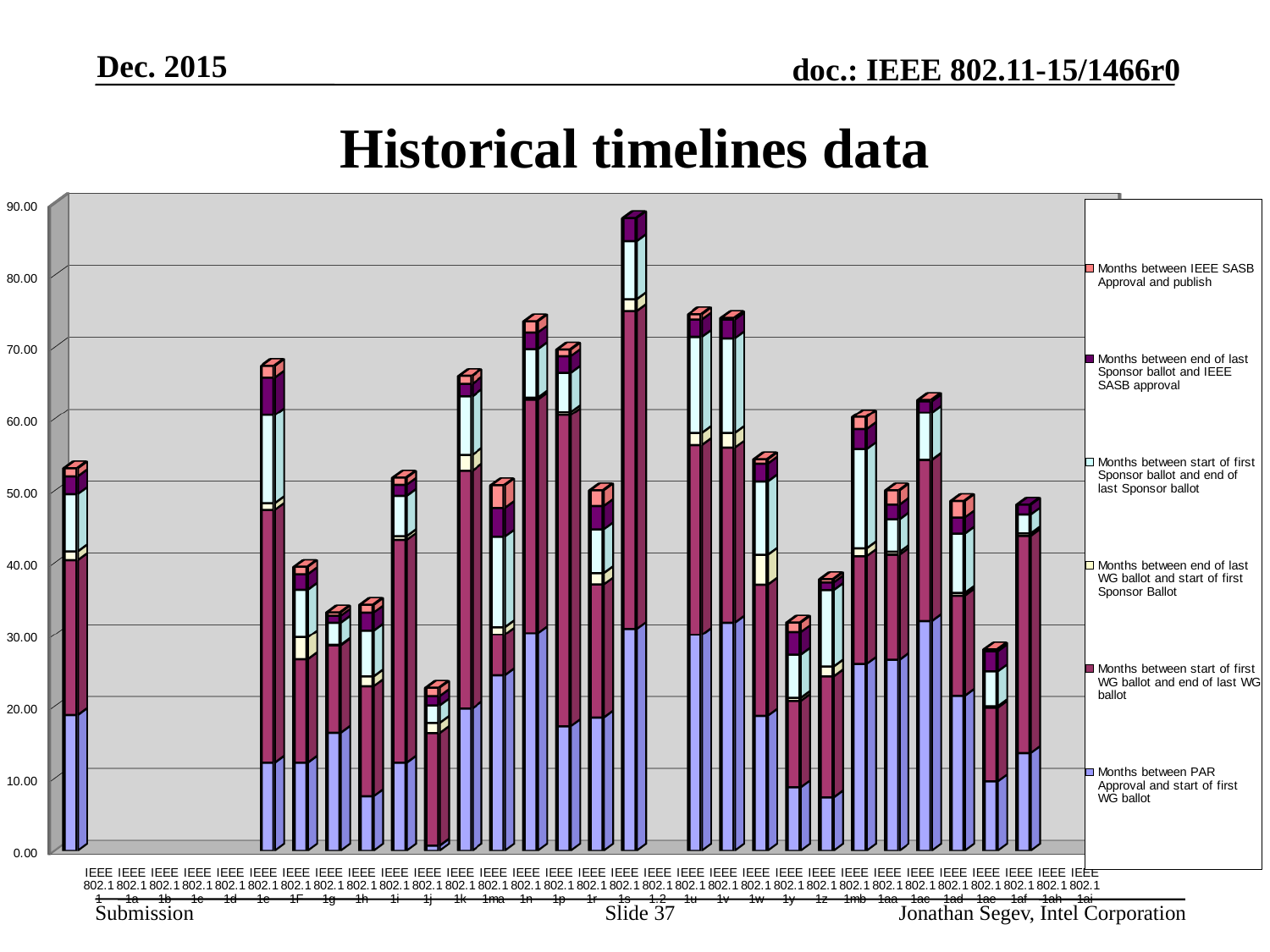
Which category has the tallest stacked bar? IEEE 802.11s Which legend entry corresponds to the bottom segment of each stacked bar? Months between PAR Approval and start of first WG ballot What kind of chart is shown on the slide? stacked bar chart Is the total for IEEE 802.11j greater or less than 30? less How many series does the legend list? 6 Is the total for IEEE 802.11n greater or less than 70? greater Which has the larger total, IEEE 802.11s or IEEE 802.11e? IEEE 802.11s Which has the larger total, IEEE 802.11j or IEEE 802.11k? IEEE 802.11k What is the title of the chart? Historical timelines data Is the total for IEEE 802.11ae greater or less than 40? less